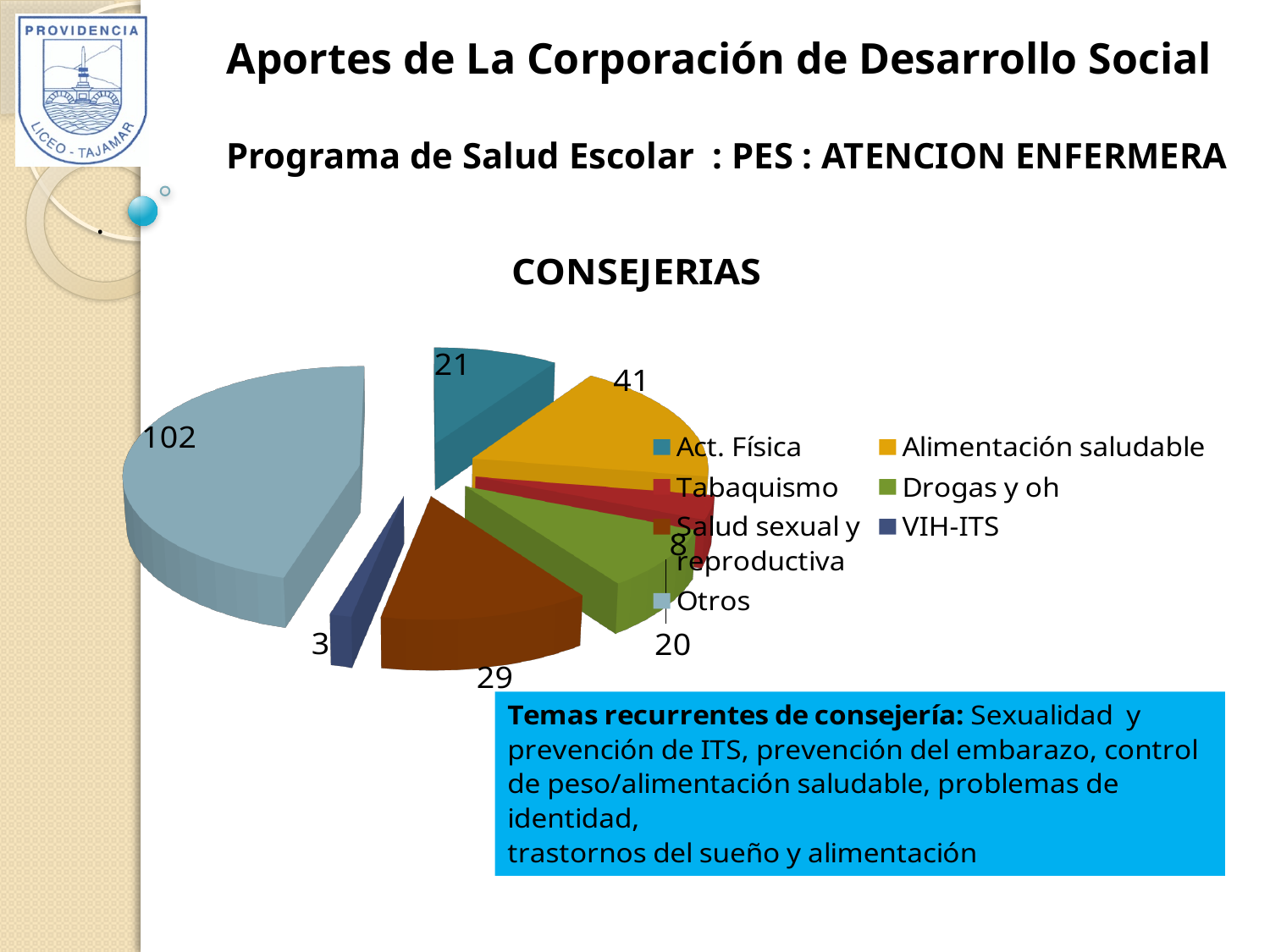
What is the value for VIH-ITS in the pie chart? 3 What is the value for Alimentación saludable in the pie chart? 41 How many categories does the legend of the pie chart list? 7 What is the title of the chart? CONSEJERIAS What is the value for Otros in the pie chart? 102 What type of chart is shown on the slide? Pie chart What is the total of all the values shown in the pie chart? 224 What is the difference between the values for Alimentación saludable and Act. Física? 20 Which category has the smallest slice in the pie chart? VIH-ITS Which is larger, the value for Drogas y oh or the value for Tabaquismo? Drogas y oh What is the value for Salud sexual y reproductiva in the pie chart? 29 Which category has the largest slice in the pie chart? Otros